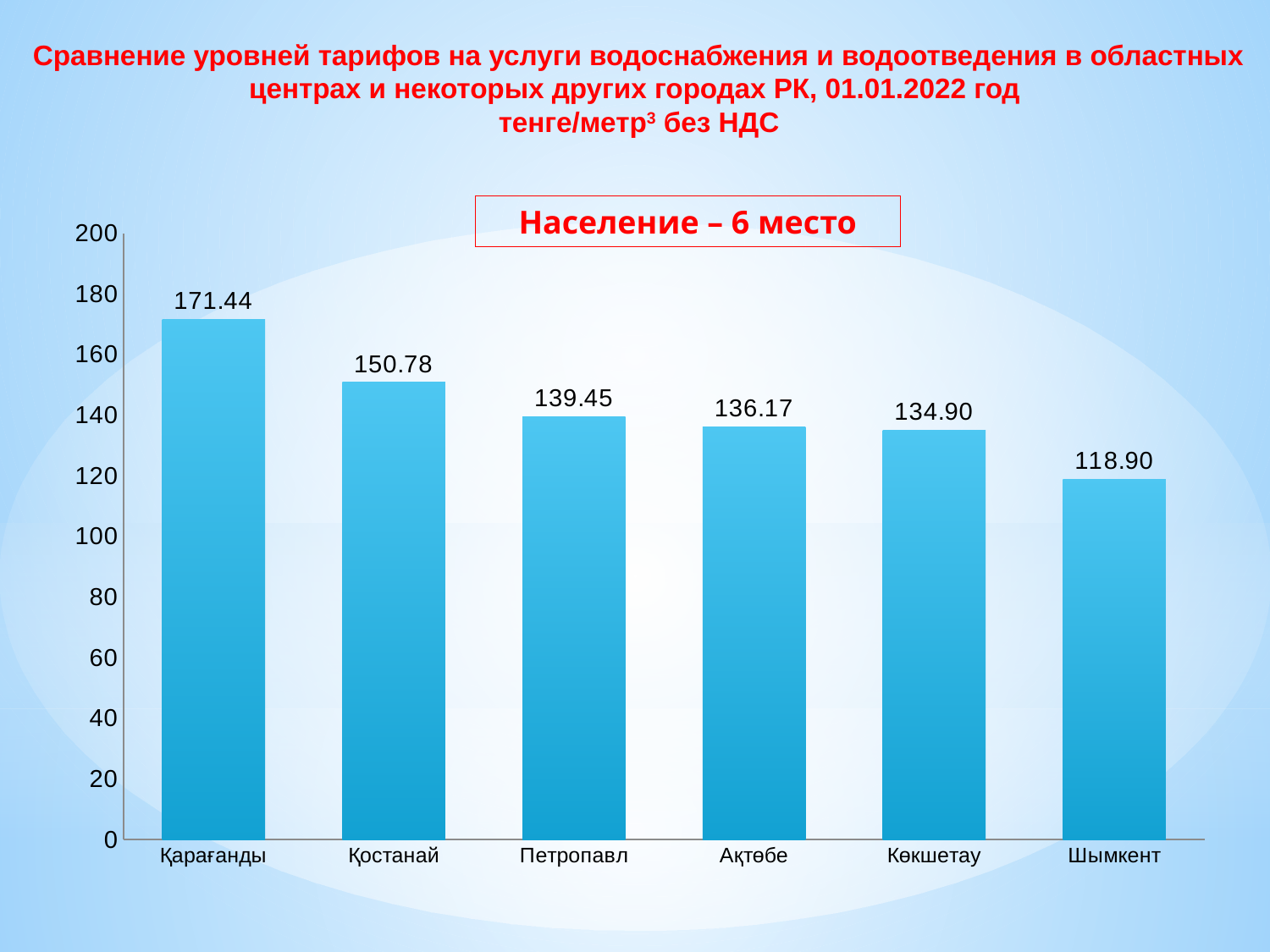
Is the value for Шымкент greater or less than 120? less Which is larger, the value for Қостанай or the value for Ақтөбе? Қостанай How many cities are shown on the chart? 6 What is the difference between the values for Көкшетау and Шымкент? 16.00 What is the value for Қарағанды? 171.44 Which city has the lowest value? Шымкент What is the difference between the values for Қарағанды and Қостанай? 20.66 What kind of chart is shown on the slide? bar chart Which city has the highest value? Қарағанды What is the value for Петропавл? 139.45 Do the values rise or fall from left to right along the x axis? fall What is the value for Шымкент? 118.90